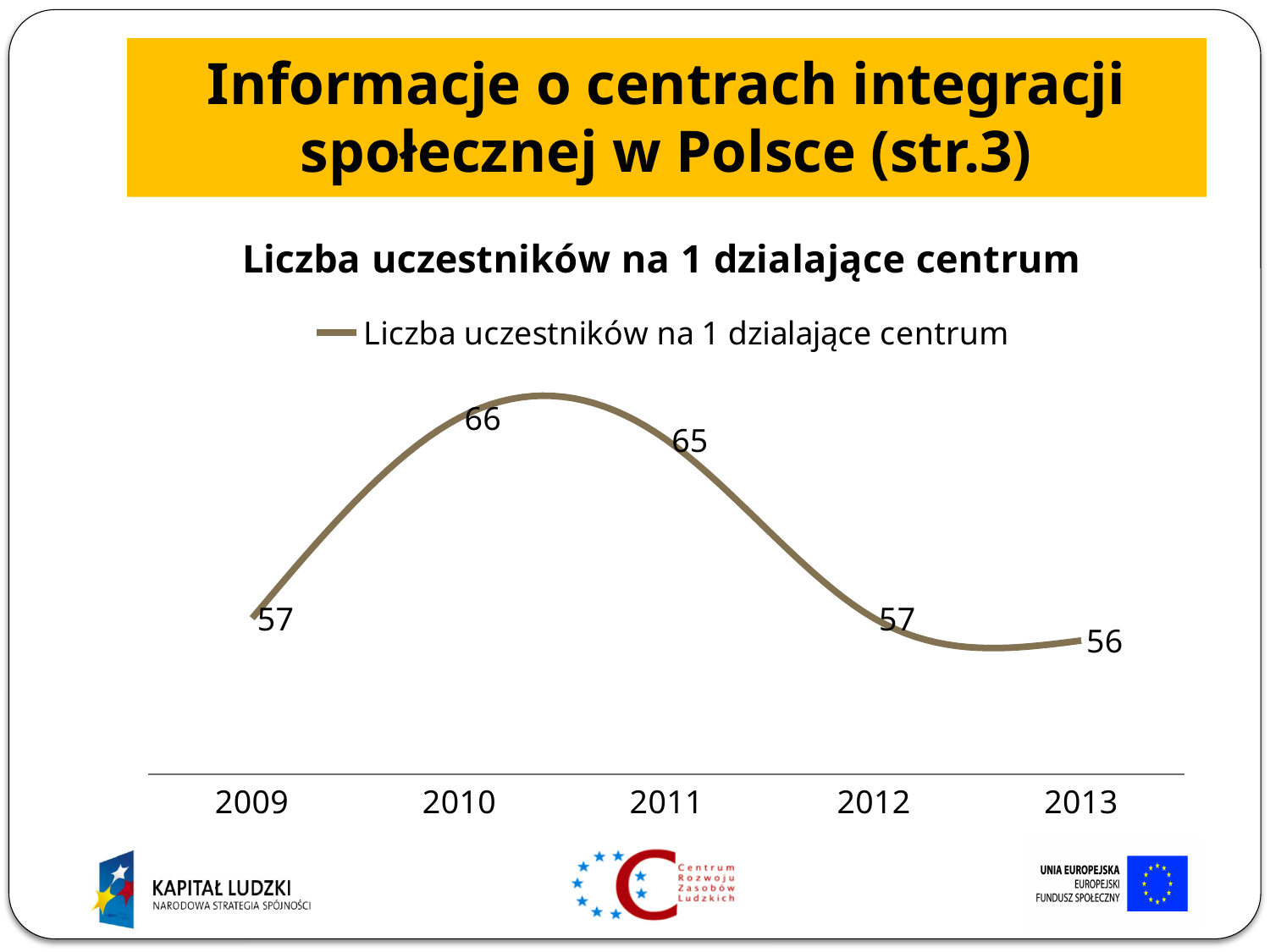
What is the difference between the values for 2010 and 2013? 10 Which year has the highest value? 2010 What kind of chart is shown? line chart What is the title of the chart? Liczba uczestników na 1 dzialające centrum How many years are plotted on the chart? 5 What is the value for 2009? 57 What is the value for 2013? 56 Which year has the lowest value? 2013 What is the value for 2011? 65 Which is larger, the value for 2011 or the value for 2012? 2011 How many series does the legend list? 1 What is the value for 2010? 66